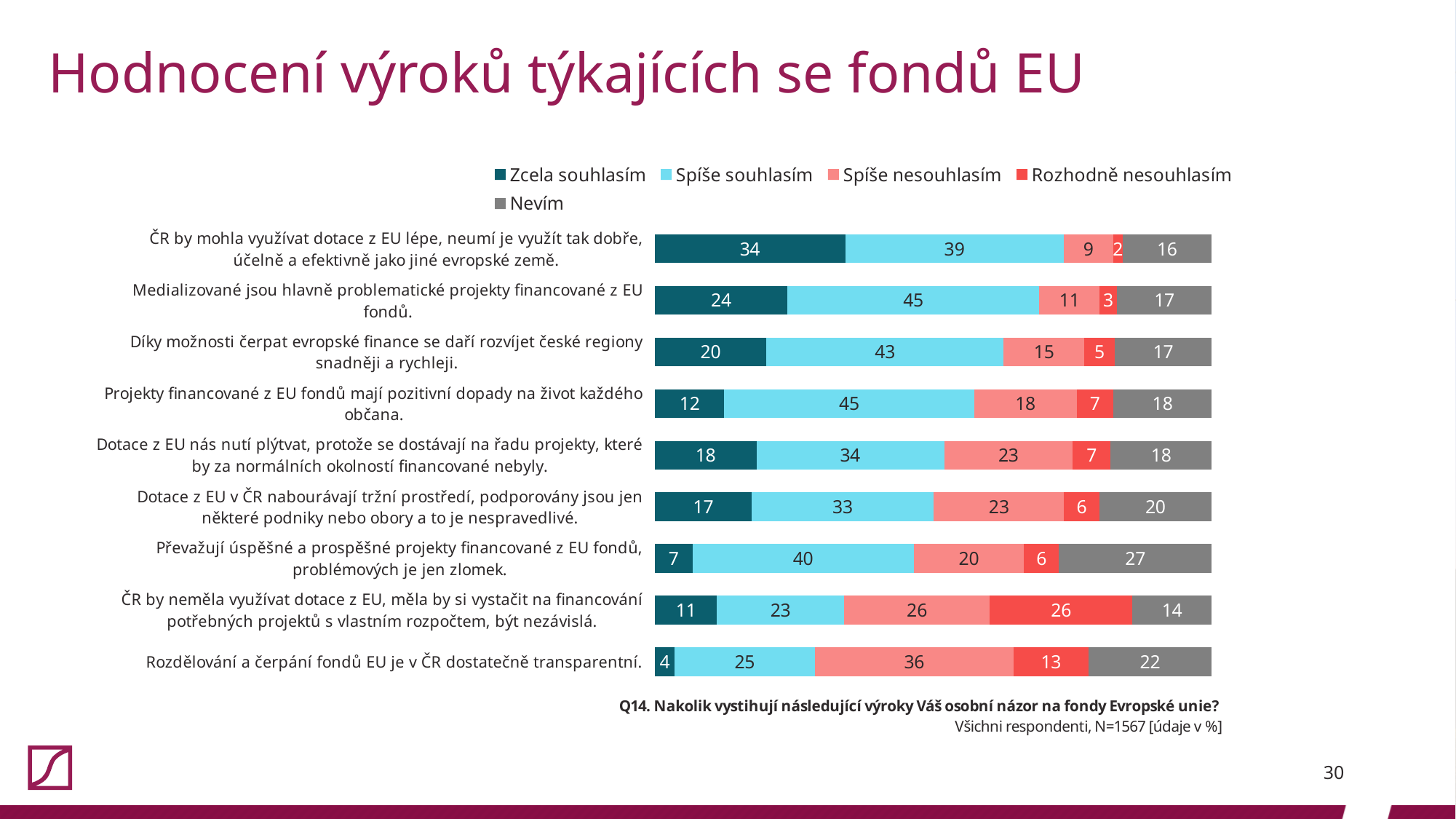
Which statement has the highest 'Spíše nesouhlasím' value? Rozdělování a čerpání fondů EU je v ČR dostatečně transparentní. What is the 'Rozhodně nesouhlasím' value for the statement 'ČR by neměla využívat dotace z EU, měla by si vystačit na financování potřebných projektů s vlastním rozpočtem, být nezávislá.'? 26 What is the total of the stacked bar for 'Díky možnosti čerpat evropské finance se daří rozvíjet české regiony snadněji a rychleji.'? 100 What kind of chart is shown on the slide? Stacked bar chart What is the difference between the 'Spíše souhlasím' values for 'Medializované jsou hlavně problematické projekty financované z EU fondů.' and 'Rozdělování a čerpání fondů EU je v ČR dostatečně transparentní.'? 20 What is the 'Zcela souhlasím' value for the statement 'ČR by mohla využívat dotace z EU lépe, neumí je využít tak dobře, účelně a efektivně jako jiné evropské země.'? 34 Which statement has the lowest 'Zcela souhlasím' value? Rozdělování a čerpání fondů EU je v ČR dostatečně transparentní. How many statements (categories) are plotted in the chart? 9 How many series does the legend list? 5 Which is larger: the 'Nevím' value for 'Dotace z EU v ČR nabourávají tržní prostředí, podporovány jsou jen některé podniky nebo obory a to je nespravedlivé.' or for 'ČR by neměla využívat dotace z EU, měla by si vystačit na financování potřebných projektů s vlastním rozpočtem, být nezávislá.'? Dotace z EU v ČR nabourávají tržní prostředí, podporovány jsou jen některé podniky nebo obory a to je nespravedlivé. Which statement has the highest 'Zcela souhlasím' value? ČR by mohla využívat dotace z EU lépe, neumí je využít tak dobře, účelně a efektivně jako jiné evropské země. What is the 'Nevím' value for the statement 'Převažují úspěšné a prospěšné projekty financované z EU fondů, problémových je jen zlomek.'? 27